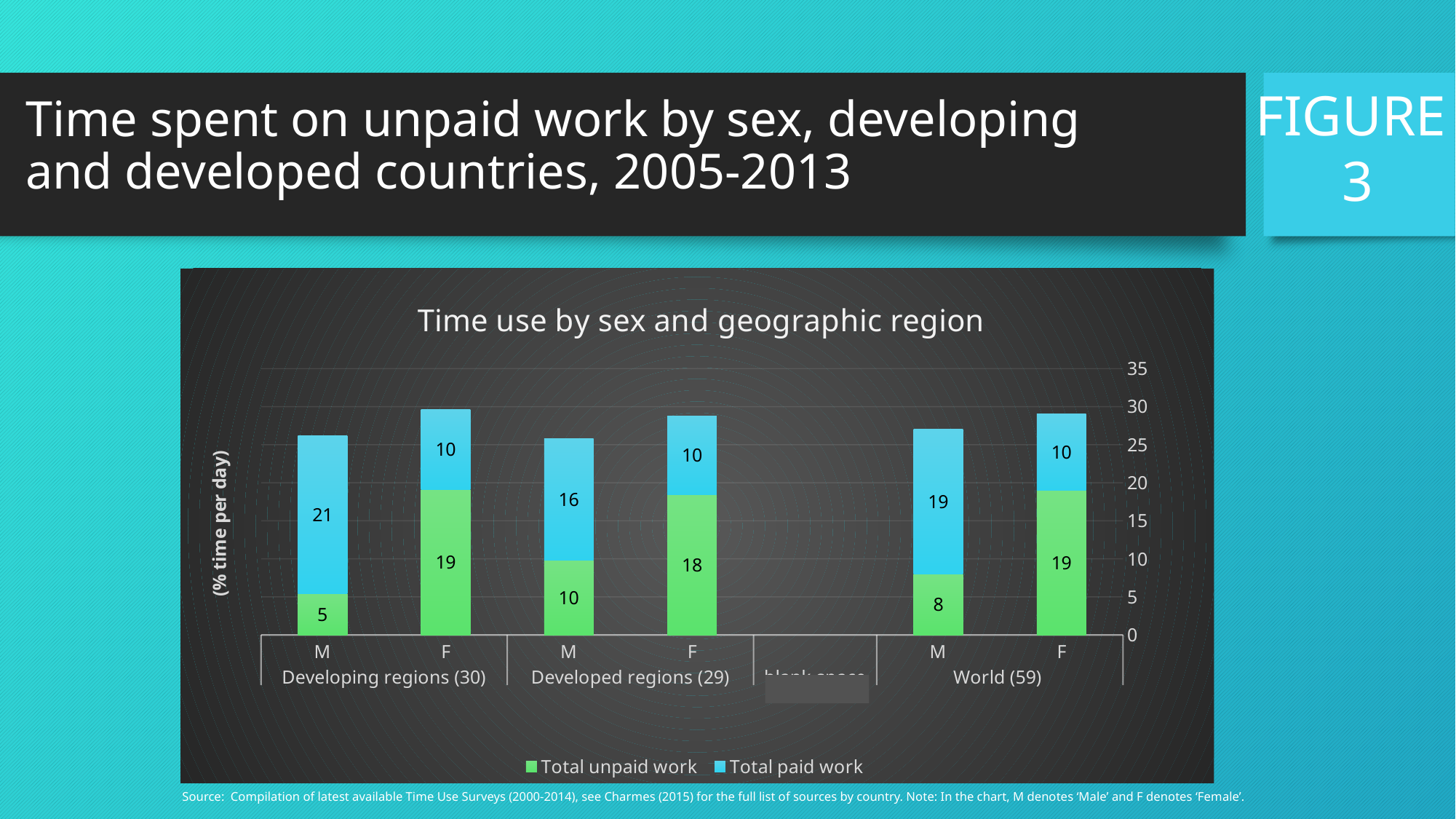
Which bar has the highest Total paid work value? M, Developing regions (30) What type of chart is shown on the slide? Stacked bar chart Which is larger: Total paid work for M in Developed regions (29) or Total paid work for M in World (59)? M in World (59) What is the value of Total unpaid work for M in Developing regions (30)? 5 What is the value of Total unpaid work for F in Developed regions (29)? 18 What is the total height of the stacked bar for F in World (59)? 29 What is the difference between Total unpaid work for F and M in Developing regions (30)? 14 What is the total height of the stacked bar for M in Developed regions (29)? 26 What is the value of Total paid work for M in World (59)? 19 Which bar has the lowest Total unpaid work value? M, Developing regions (30) How many series does the legend list? 2 What is the value of Total paid work for F in Developed regions (29)? 10